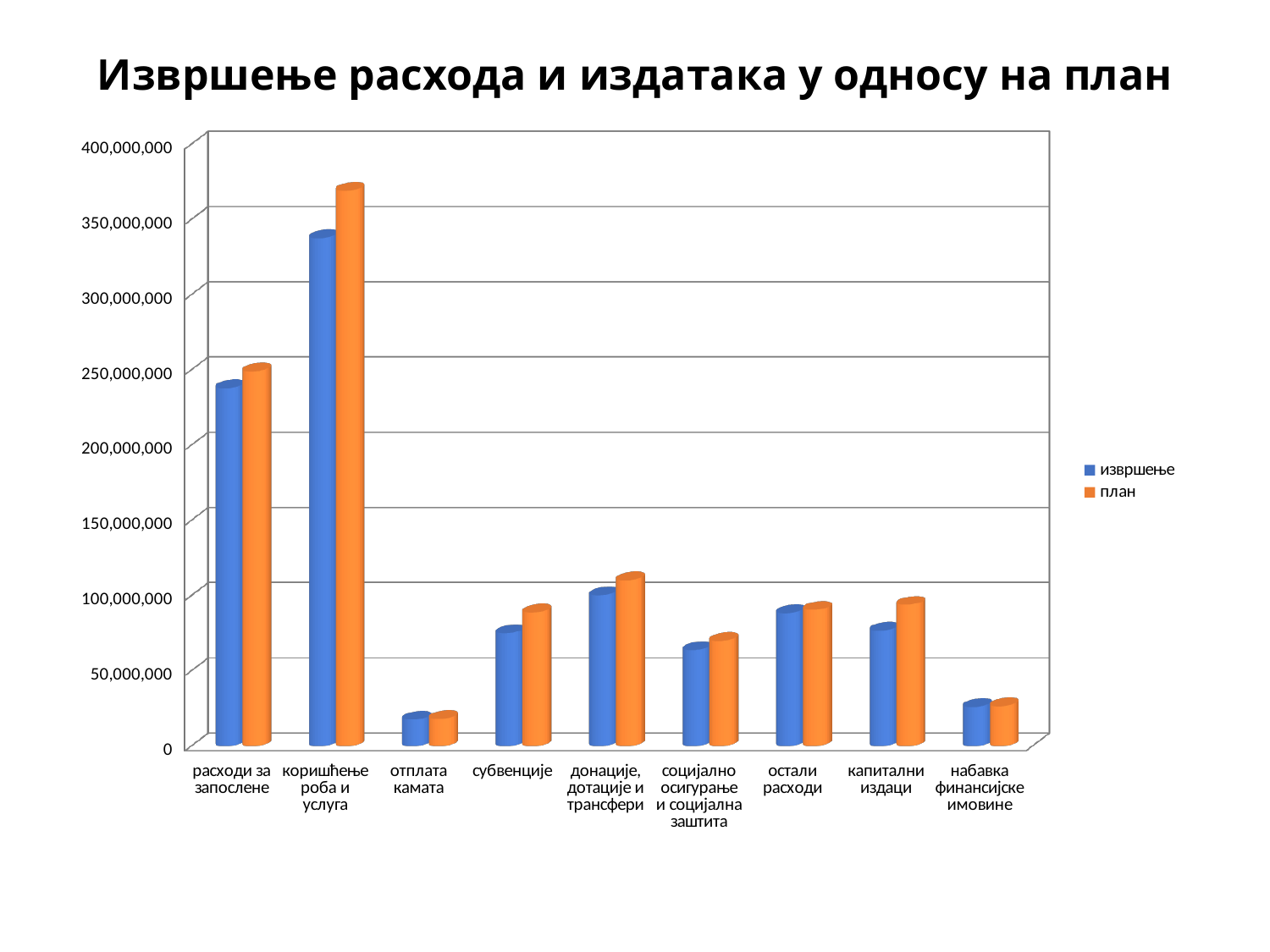
How many categories are shown on the x axis? 9 Is the извршење value for расходи за запослене greater or less than 250,000,000? less Is the план value for коришћење роба и услуга greater or less than 350,000,000? greater What is the title of the chart? Извршење расхода и издатака у односу на план Which category has the highest план value? коришћење роба и услуга How many series does the legend list? 2 What kind of chart is shown on the slide? bar chart Which category has the larger извршење value, расходи за запослене or донације, дотације и трансфери? расходи за запослене Which category has the lowest извршење value? отплата камата Is the извршење value for субвенције greater or less than 50,000,000? greater Which is larger for капитални издаци, извршење or план? план